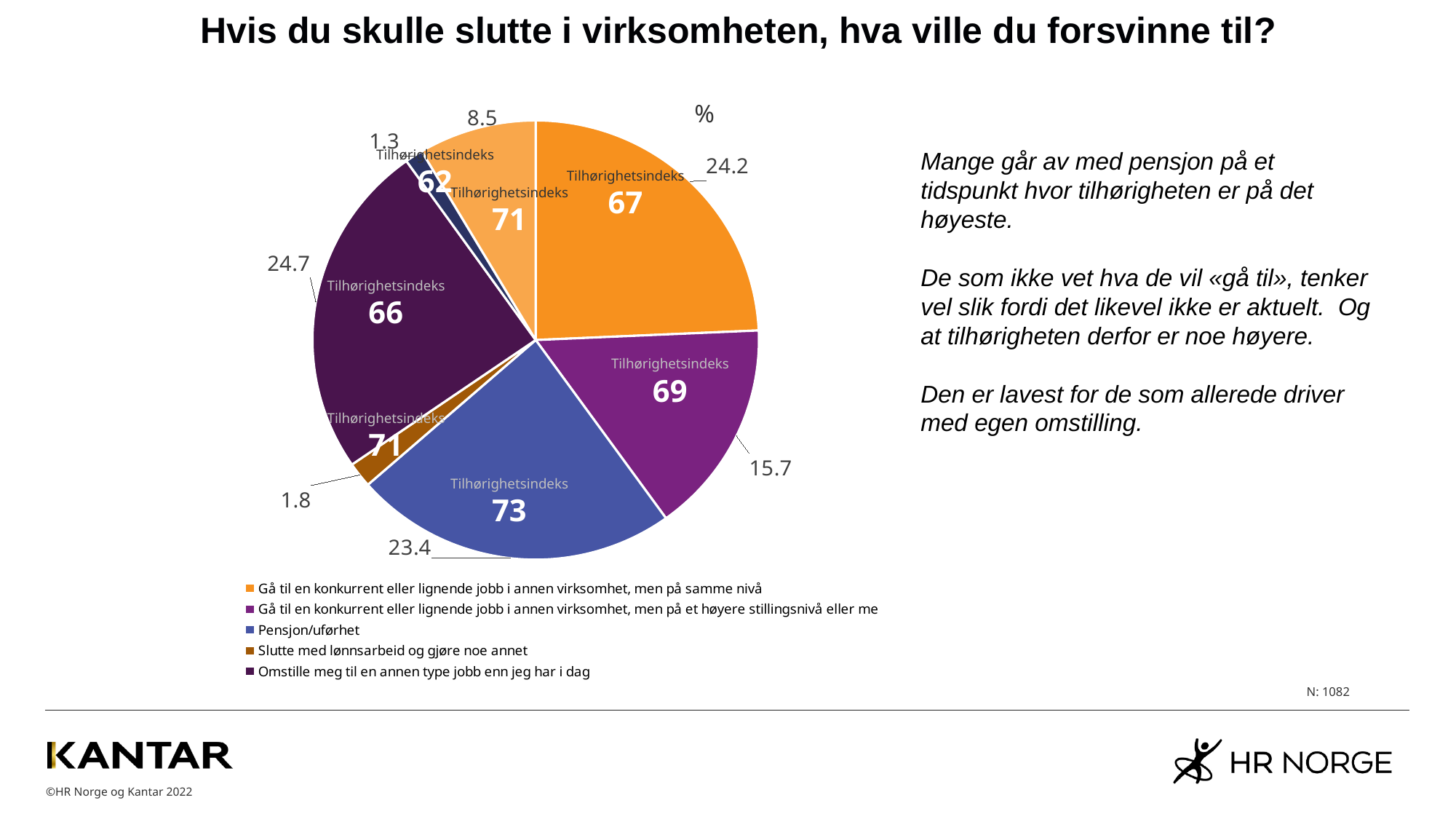
What percentage of respondents chose Pensjon/uførhet? 23.4 Which is larger: the share for Pensjon/uførhet or the share for going to a competitor at a higher level (Gå til en konkurrent ... høyere stillingsnivå eller me)? Pensjon/uførhet What is the Tilhørighetsindeks value shown in the Pensjon/uførhet slice? 73 Which legend category has the largest share of the pie? Omstille meg til en annen type jobb enn jeg har i dag What percentage of respondents chose Slutte med lønnsarbeid og gjøre noe annet? 1.8 How many entries does the legend list? 5 What percentage of respondents would go to a competitor or similar job at the same level (Gå til en konkurrent eller lignende jobb i annen virksomhet, men på samme nivå)? 24.2 What is the Tilhørighetsindeks value shown in the Omstille meg til en annen type jobb enn jeg har i dag slice? 66 What percentage of respondents chose Omstille meg til en annen type jobb enn jeg har i dag? 24.7 What is the smallest percentage value printed on the pie chart? 1.3 What type of chart is shown on the slide? pie chart What is the difference in percentage between going to a competitor at the same level (24.2) and going to a competitor at a higher level (15.7)? 8.5